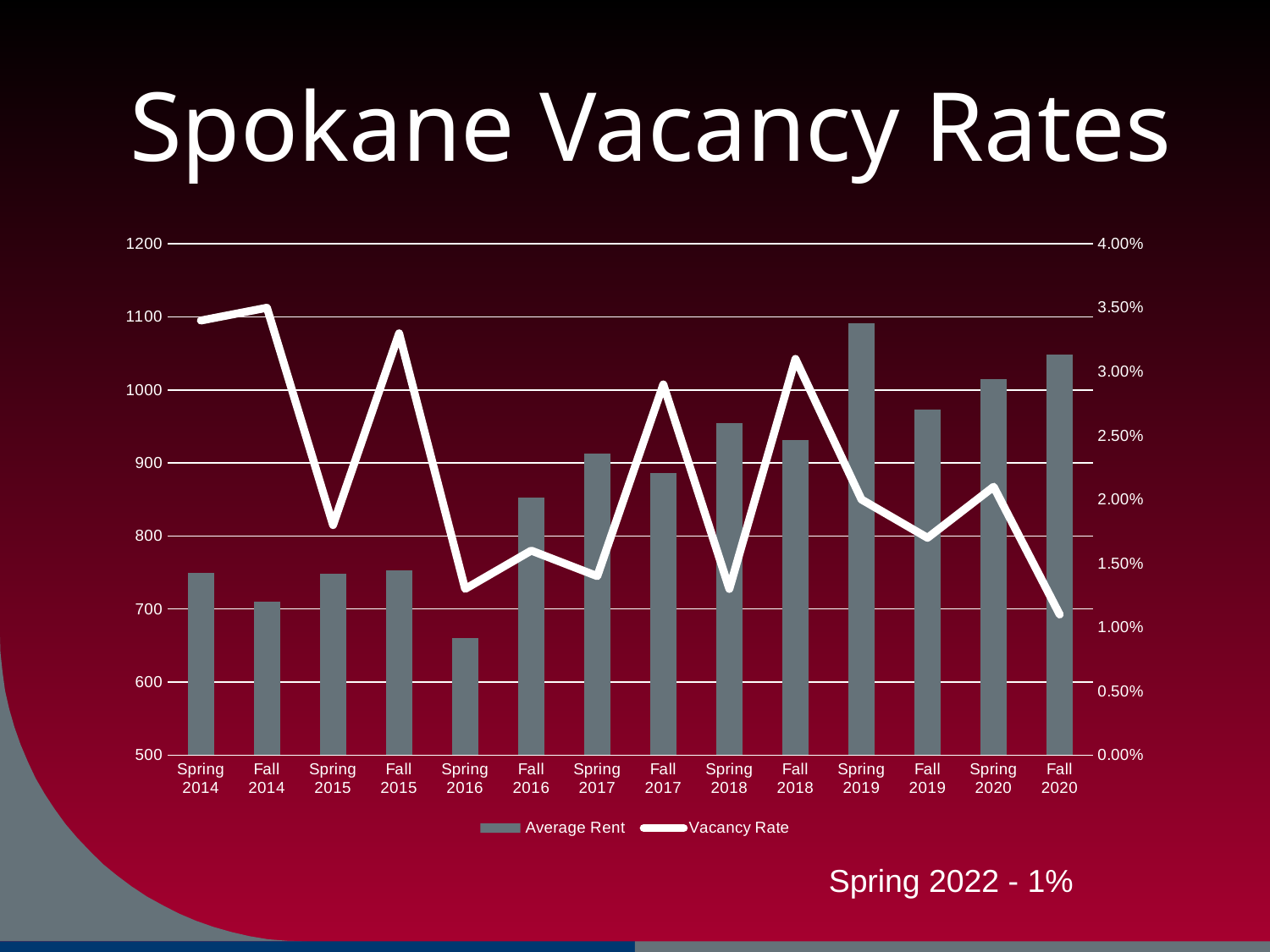
Is the Vacancy Rate for Fall 2020 greater or less than 1.50%? less Which period has the highest Average Rent bar? Spring 2019 How many series does the legend list? 2 What kind of chart is shown on the slide? Combination bar and line chart Is the Vacancy Rate for Fall 2014 greater or less than 3.00%? greater What is the title of the chart? Spokane Vacancy Rates Which has the higher Average Rent, Spring 2019 or Fall 2019? Spring 2019 Is the Average Rent for Spring 2016 greater or less than 700? less Does the Average Rent generally rise or fall from Spring 2014 to Fall 2020? rise How many time periods are shown on the x axis? 14 Which period has the lowest Average Rent bar? Spring 2016